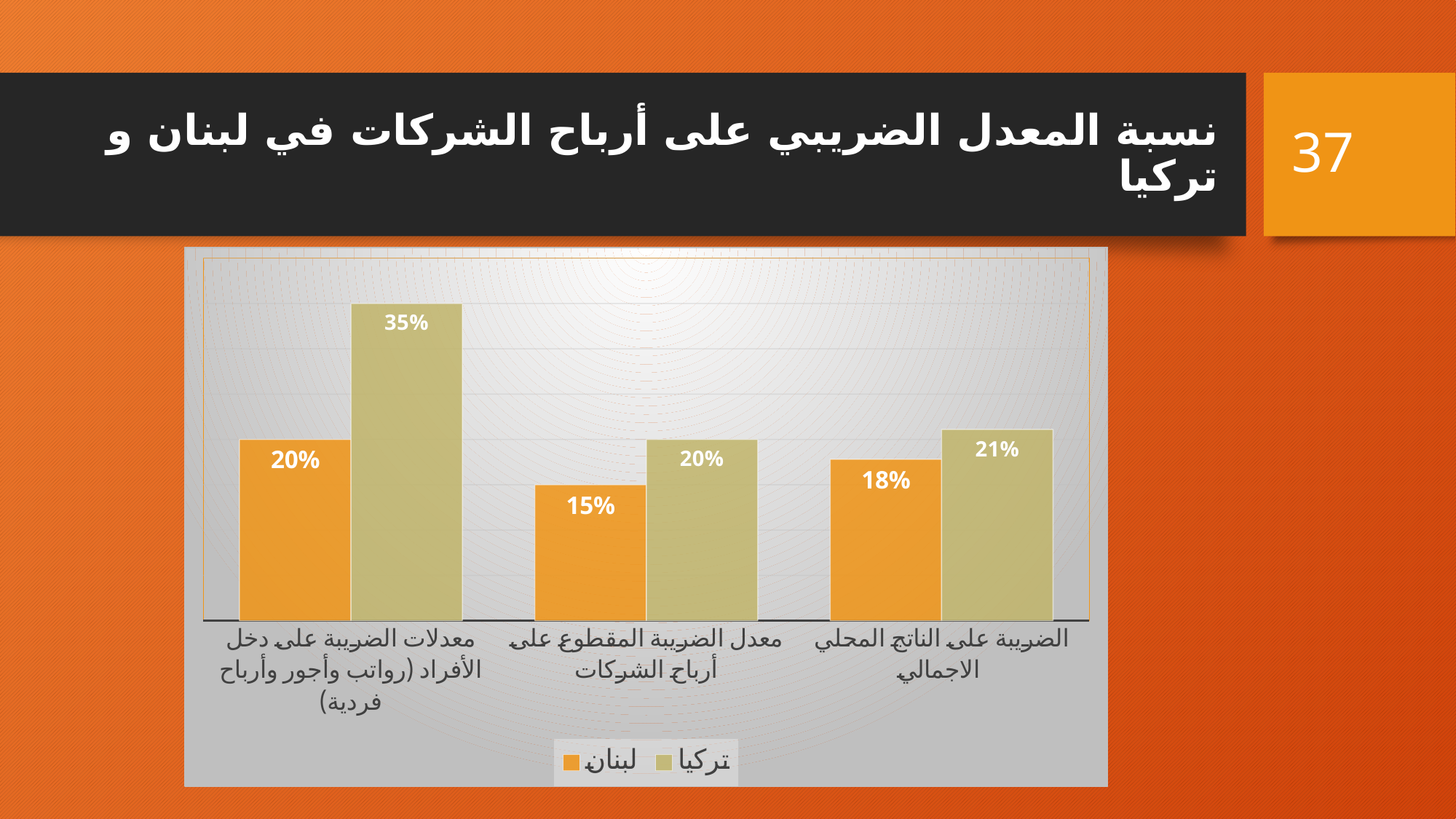
Which category has the highest value for تركيا? معدلات الضريبة على دخل الأفراد (رواتب وأجور وأرباح فردية) What is the value for تركيا in the category الضريبة على الناتج المحلي الاجمالي? 21% What is the difference between the تركيا and لبنان values in the category معدلات الضريبة على دخل الأفراد (رواتب وأجور وأرباح فردية)? 15% How many categories are shown on the x axis? 3 How many series does the legend list? 2 In the category معدل الضريبة المقطوع على أرباح الشركات, which series has the larger value, لبنان or تركيا? تركيا What is the value for لبنان in the category معدل الضريبة المقطوع على أرباح الشركات? 15% Which series is shown in orange in the legend? لبنان What is the value for تركيا in the category معدلات الضريبة على دخل الأفراد (رواتب وأجور وأرباح فردية)? 35% What type of chart is shown on the slide? bar chart What is the value for لبنان in the category الضريبة على الناتج المحلي الاجمالي? 18% Which category has the lowest value for لبنان? معدل الضريبة المقطوع على أرباح الشركات